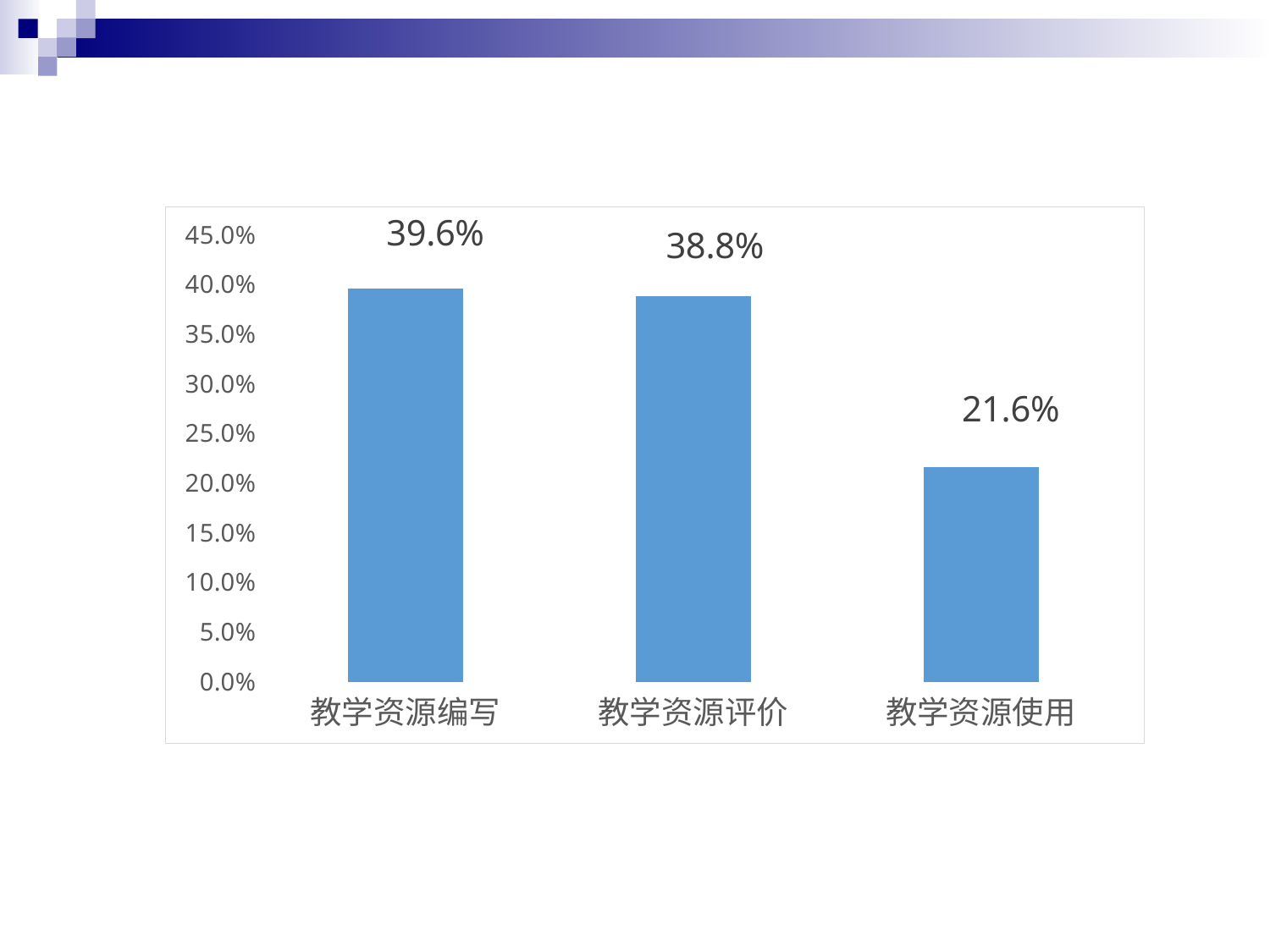
Which category has the highest value? 教学资源编写 What is the value for 教学资源编写? 39.6% Which is larger, the value for 教学资源评价 or the value for 教学资源使用? 教学资源评价 Which category has the lowest value? 教学资源使用 What is the highest value shown on the vertical axis? 45.0% What is the difference between the values for 教学资源编写 and 教学资源评价? 0.8% How many categories are shown on the chart? 3 What is the difference between the values for 教学资源编写 and 教学资源使用? 18.0% What is the value for 教学资源使用? 21.6% What is the value for 教学资源评价? 38.8% What kind of chart is shown on the slide? bar chart Is the value for 教学资源使用 greater or less than 25.0%? less